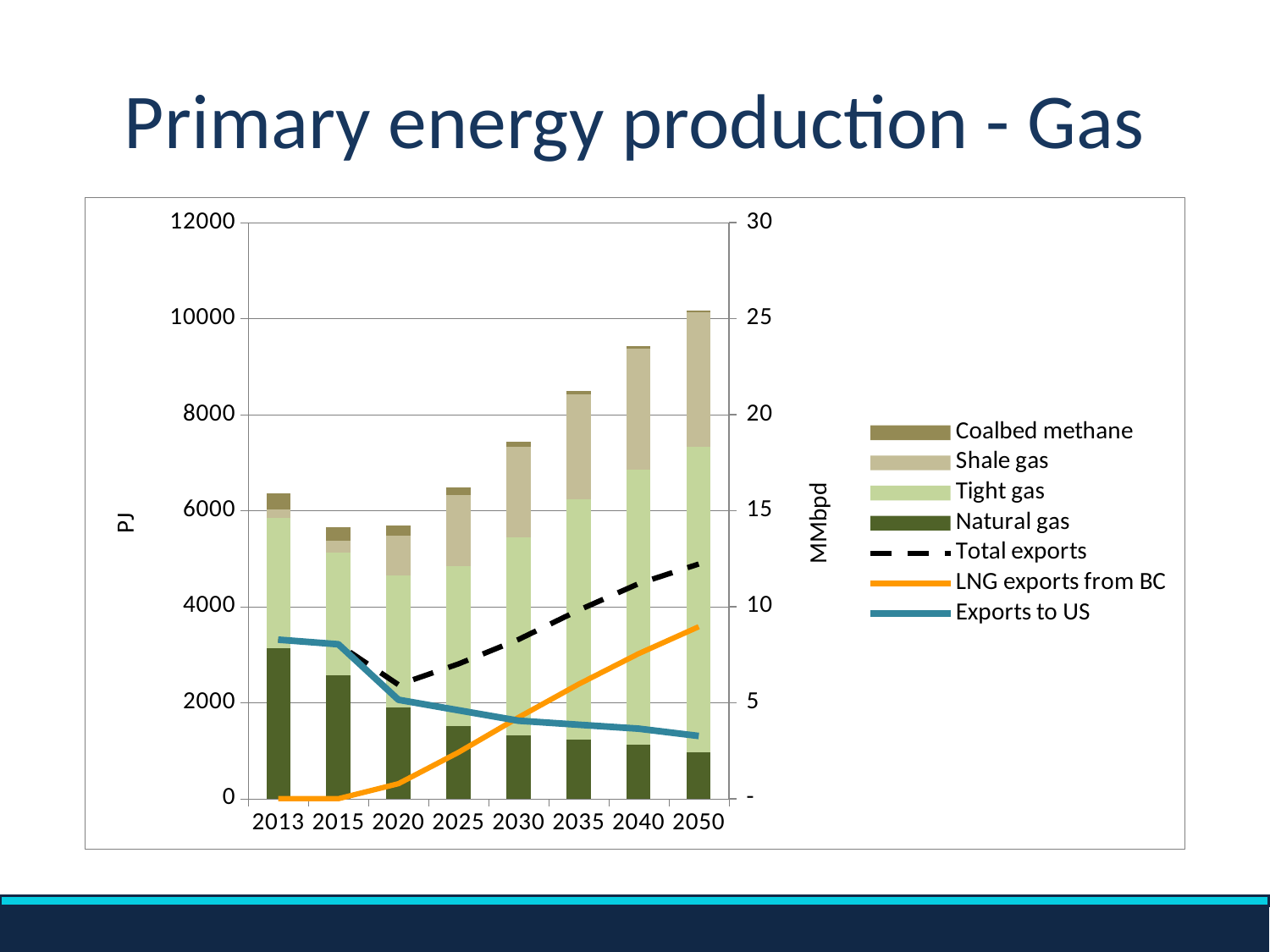
Is the total stacked bar for 2040 greater or less than 8000 PJ? greater How many series does the legend list? 7 How many years are shown along the x axis? 8 Is the Exports to US value in 2013 greater or less than 5 MMbpd? greater Is the Natural gas value for 2050 greater or less than 2000 PJ? less What is the label on the right-hand vertical axis? MMbpd Does the LNG exports from BC line rise or fall from 2013 to 2050? rise In which year is the Natural gas segment the largest? 2013 What kind of chart is shown on the slide? A combined stacked bar and line chart In 2050, which is larger: LNG exports from BC or Exports to US? LNG exports from BC Which year has the tallest stacked bar? 2050